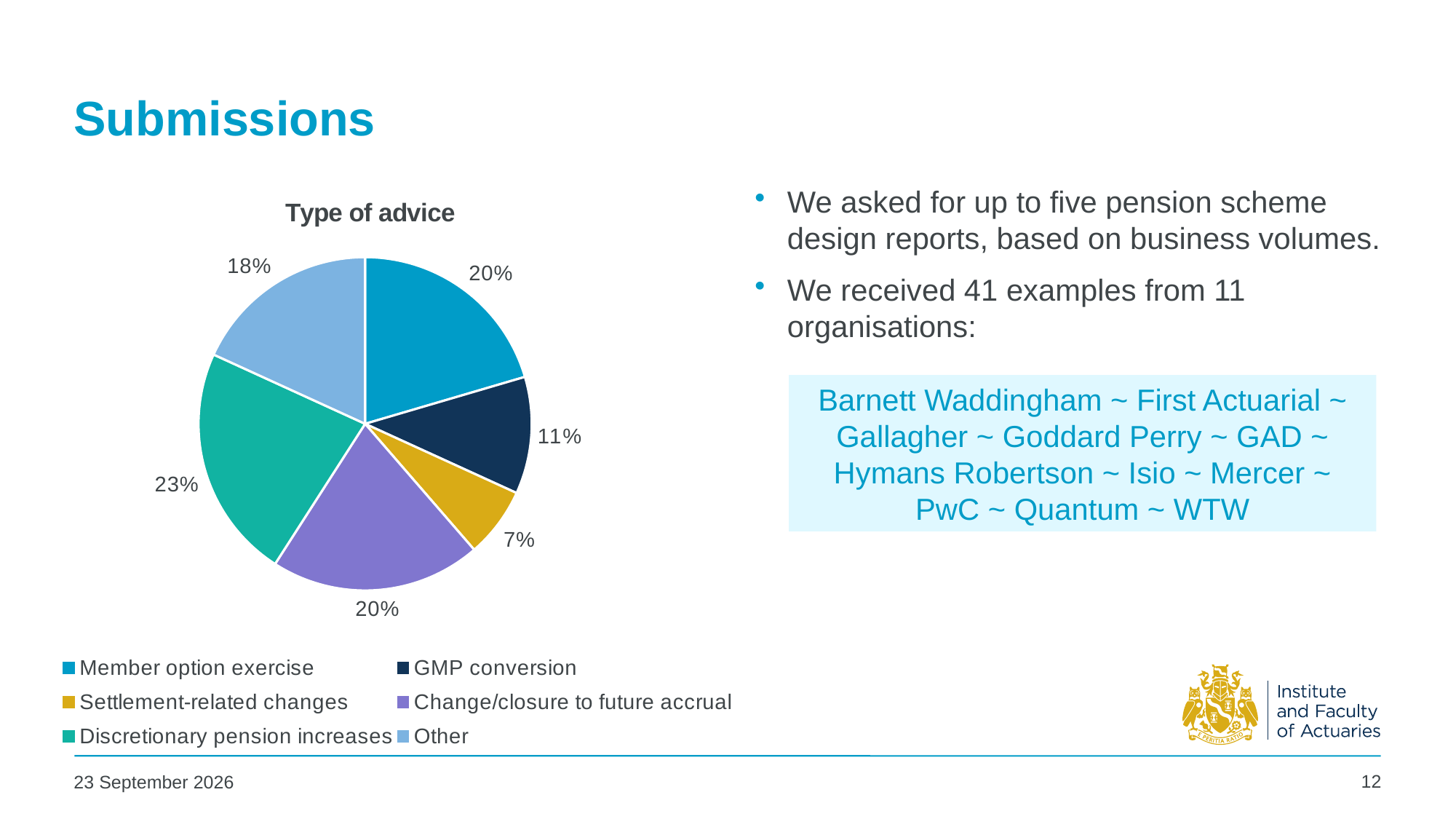
What share of the pie is Discretionary pension increases? 23% What share of the pie is GMP conversion? 11% What share of the pie is Settlement-related changes? 7% Which is larger, the share for GMP conversion or the share for Other? Other What type of chart is shown on the slide? Pie chart How many categories does the pie chart have? 6 Which type of advice has the smallest share of the pie? Settlement-related changes What is the difference in percentage points between Discretionary pension increases and Settlement-related changes? 16 What is the title of the chart? Type of advice Which type of advice has the largest share of the pie? Discretionary pension increases